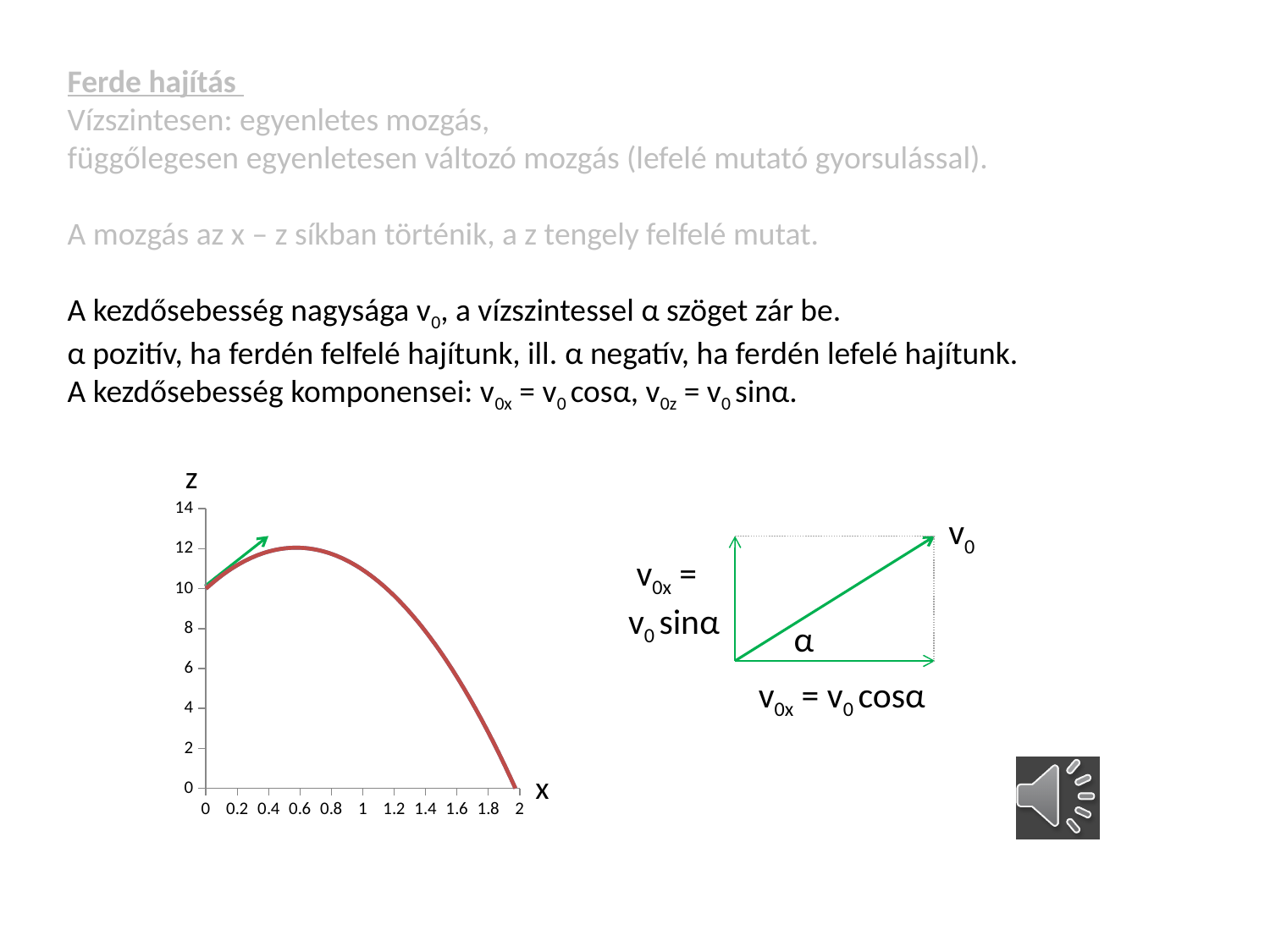
How many tick labels are shown on the x axis? 11 What is the highest tick value shown on the z axis? 14 How does the curve behave as x increases from 0 to 2? rises first, then falls What kind of chart is shown on the slide? line chart What is the label of the vertical axis of the chart? z What is the label of the horizontal axis of the chart? x What is the value of z at x = 0 on the chart? 10 Is the value of z at x = 1.8 greater or less than 4? less Is the value of z at x = 1 greater or less than 10? greater Which has the larger z value on the curve: x = 0.2 or x = 1.8? x = 0.2